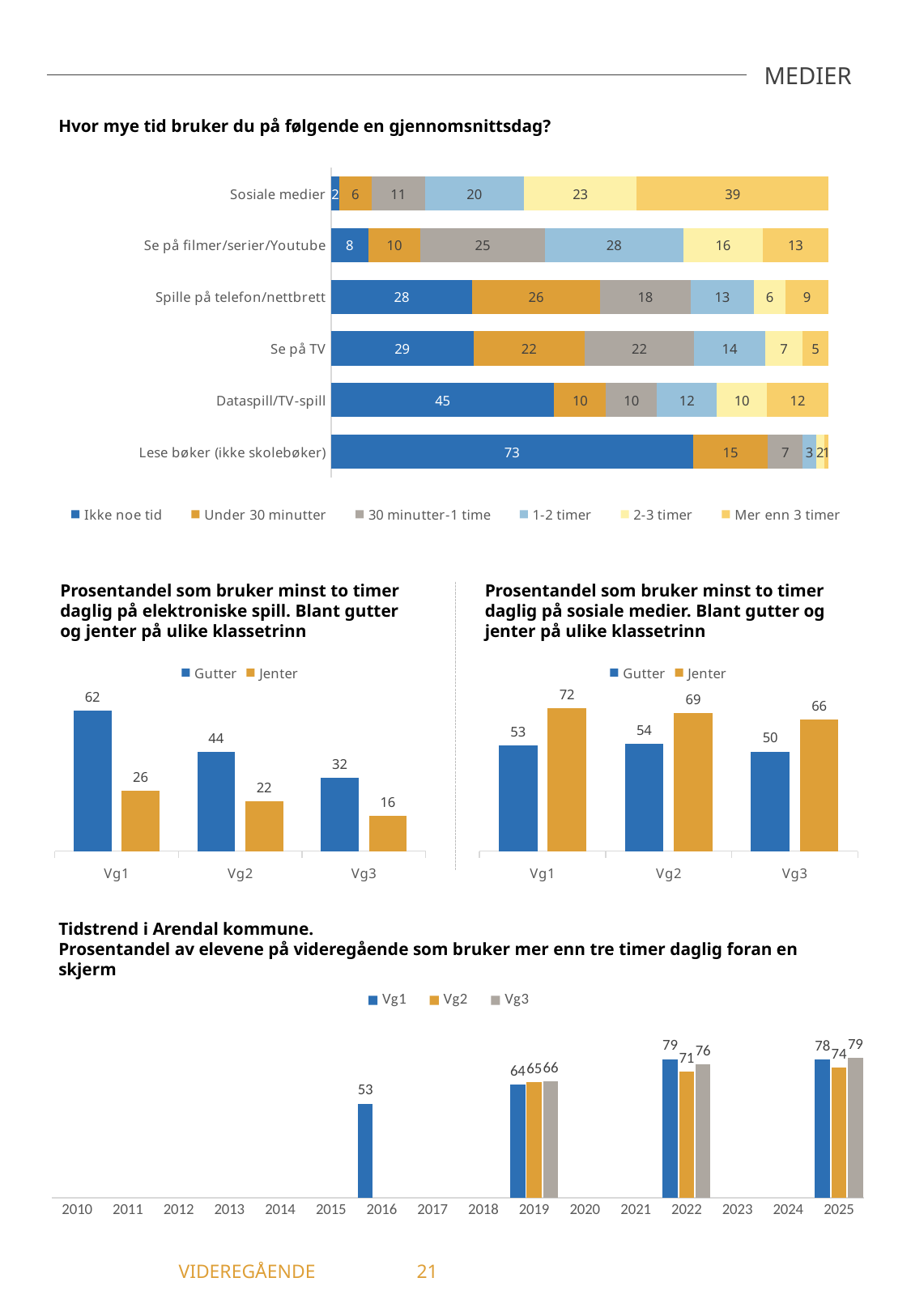
In the top chart 'Hvor mye tid bruker du på følgende en gjennomsnittsdag?', what is the value for 'Mer enn 3 timer' for 'Sosiale medier'? 39 In the chart 'Prosentandel som bruker minst to timer daglig på elektroniske spill', do the Gutter values rise or fall from Vg1 to Vg3? fall In the chart 'Prosentandel som bruker minst to timer daglig på sosiale medier', which is larger at Vg3, Gutter or Jenter? Jenter In the top chart 'Hvor mye tid bruker du på følgende en gjennomsnittsdag?', what is the value for 'Ikke noe tid' for 'Lese bøker (ikke skolebøker)'? 73 In the chart 'Prosentandel som bruker minst to timer daglig på elektroniske spill', what is the value for Gutter at Vg1? 62 In the top chart 'Hvor mye tid bruker du på følgende en gjennomsnittsdag?', how many series does the legend list? 6 What kind of chart is the bottom chart 'Tidstrend i Arendal kommune'? bar chart In the bottom chart 'Tidstrend i Arendal kommune', what is the value for Vg1 in 2016? 53 In the top chart 'Hvor mye tid bruker du på følgende en gjennomsnittsdag?', which category has the highest value for 'Ikke noe tid'? Lese bøker (ikke skolebøker) In the chart 'Prosentandel som bruker minst to timer daglig på elektroniske spill', what is the difference between Gutter and Jenter at Vg2? 22 In the top chart 'Hvor mye tid bruker du på følgende en gjennomsnittsdag?', how many activity categories are shown? 6 In the chart 'Prosentandel som bruker minst to timer daglig på sosiale medier', what is the value for Jenter at Vg1? 72